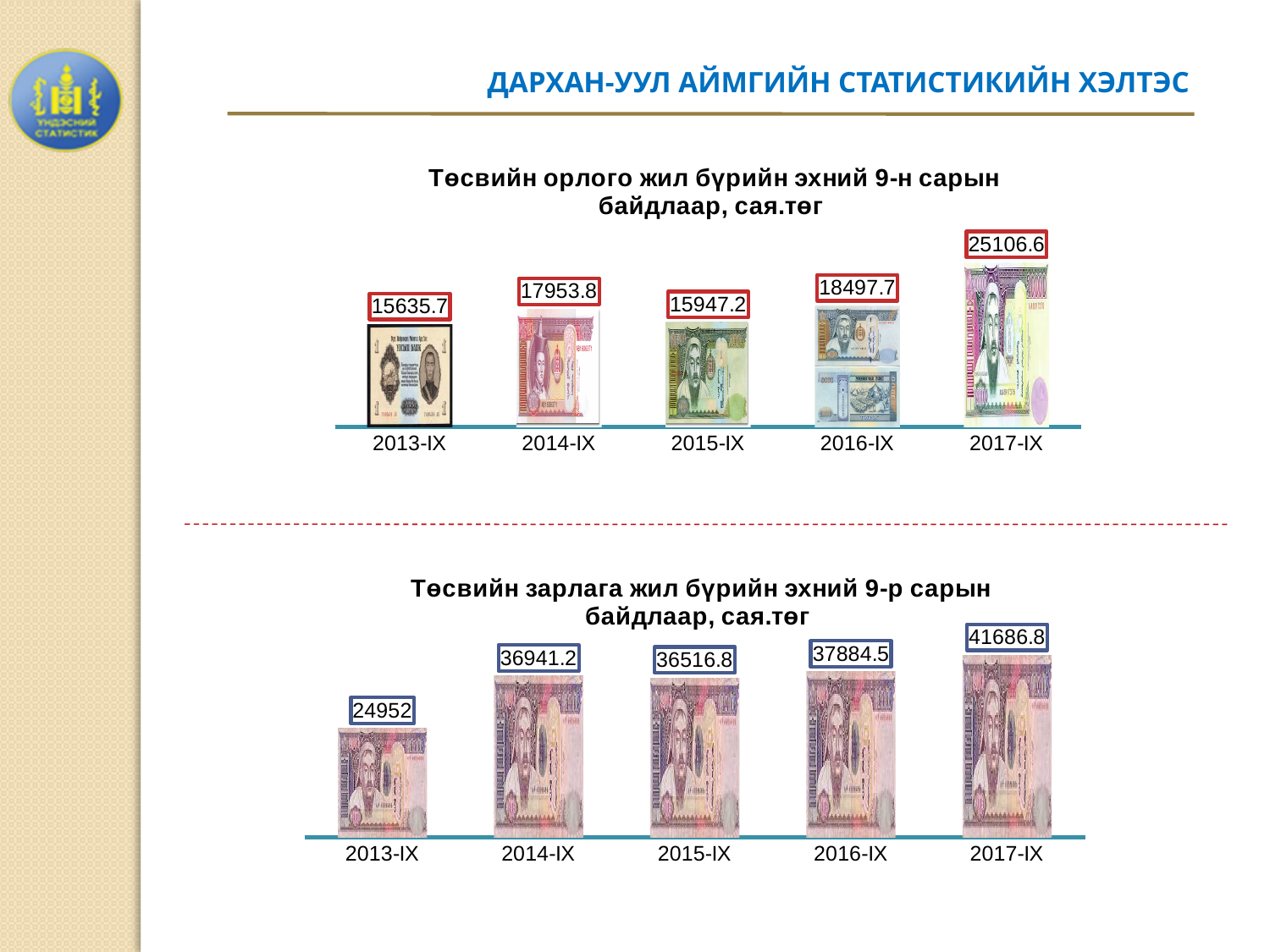
What kind of chart is the top chart (Төсвийн орлого)? bar chart In the bottom chart (Төсвийн зарлага), what is the value for 2016-IX? 37884.5 In the top chart (Төсвийн орлого), what is the value for 2013-IX? 15635.7 In the bottom chart (Төсвийн зарлага), what is the value for 2013-IX? 24952 How many years are shown on the x axis of the bottom chart (Төсвийн зарлага)? 5 In the top chart (Төсвийн орлого), which year has the lowest value? 2013-IX In the top chart (Төсвийн орлого), which is larger, the value for 2014-IX or 2015-IX? 2014-IX In the top chart (Төсвийн орлого), what is the difference between the 2017-IX and 2016-IX values? 6608.9 In the bottom chart (Төсвийн зарлага), what is the difference between the 2014-IX and 2013-IX values? 11989.2 In the top chart (Төсвийн орлого), what is the value for 2017-IX? 25106.6 In the bottom chart (Төсвийн зарлага), which year has the highest value? 2017-IX In the top chart (Төсвийн орлого), which year has the highest value? 2017-IX